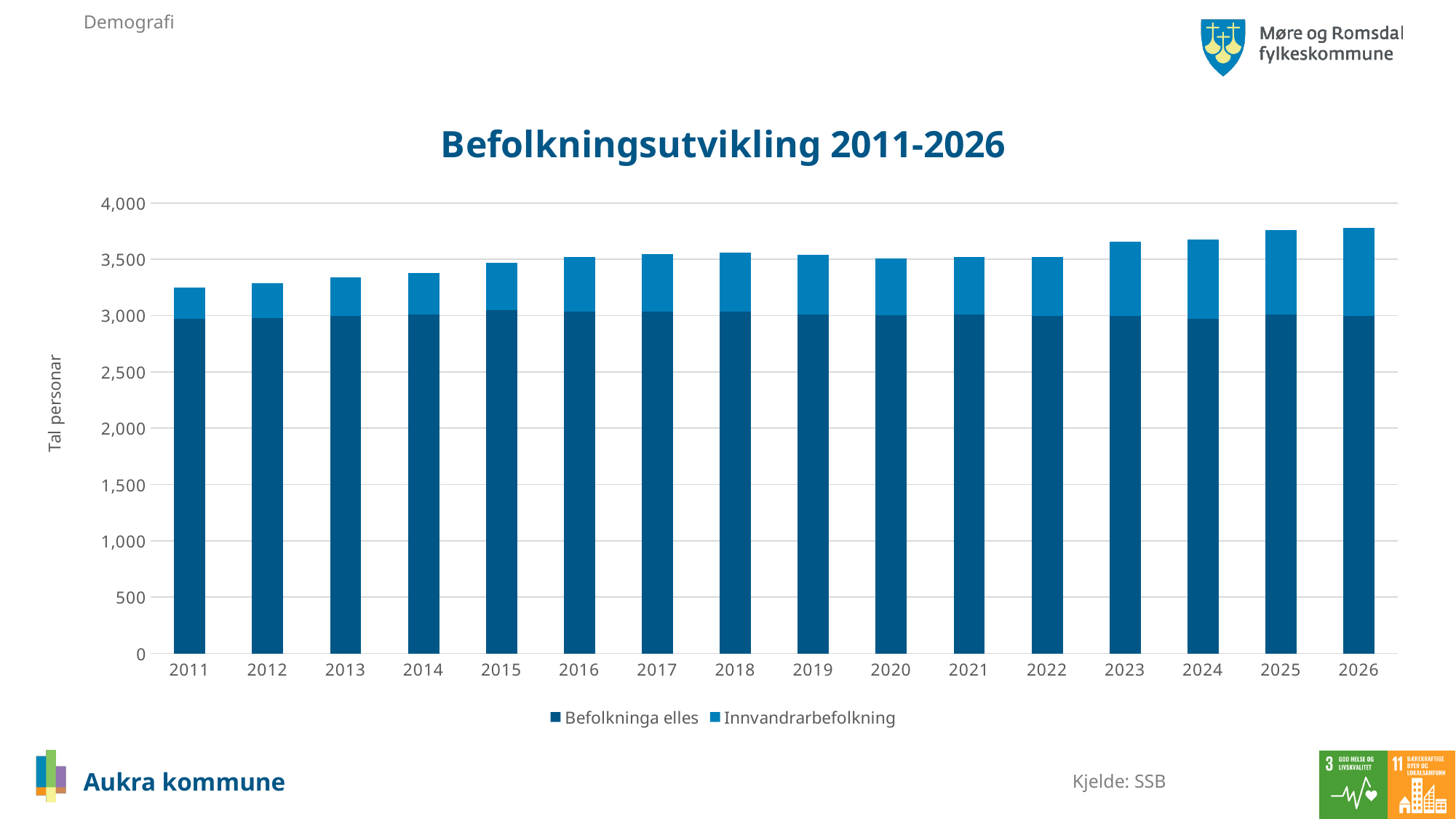
How many years are shown along the x axis? 16 Is the total bar for 2013 greater or less than 3,500? less Which year has the highest total bar? 2026 Which year has the lowest total bar? 2011 What is the label on the y axis? Tal personar What kind of chart is shown on the slide? bar chart What is the title of the chart? Befolkningsutvikling 2011-2026 Is the total bar for 2026 greater or less than 3,500? greater How many series does the legend list? 2 Which is larger, the total bar for 2026 or the total bar for 2011? 2026 Is the total bar for 2011 greater or less than 3,000? greater Do the total bars generally rise or fall from 2011 to 2026? rise